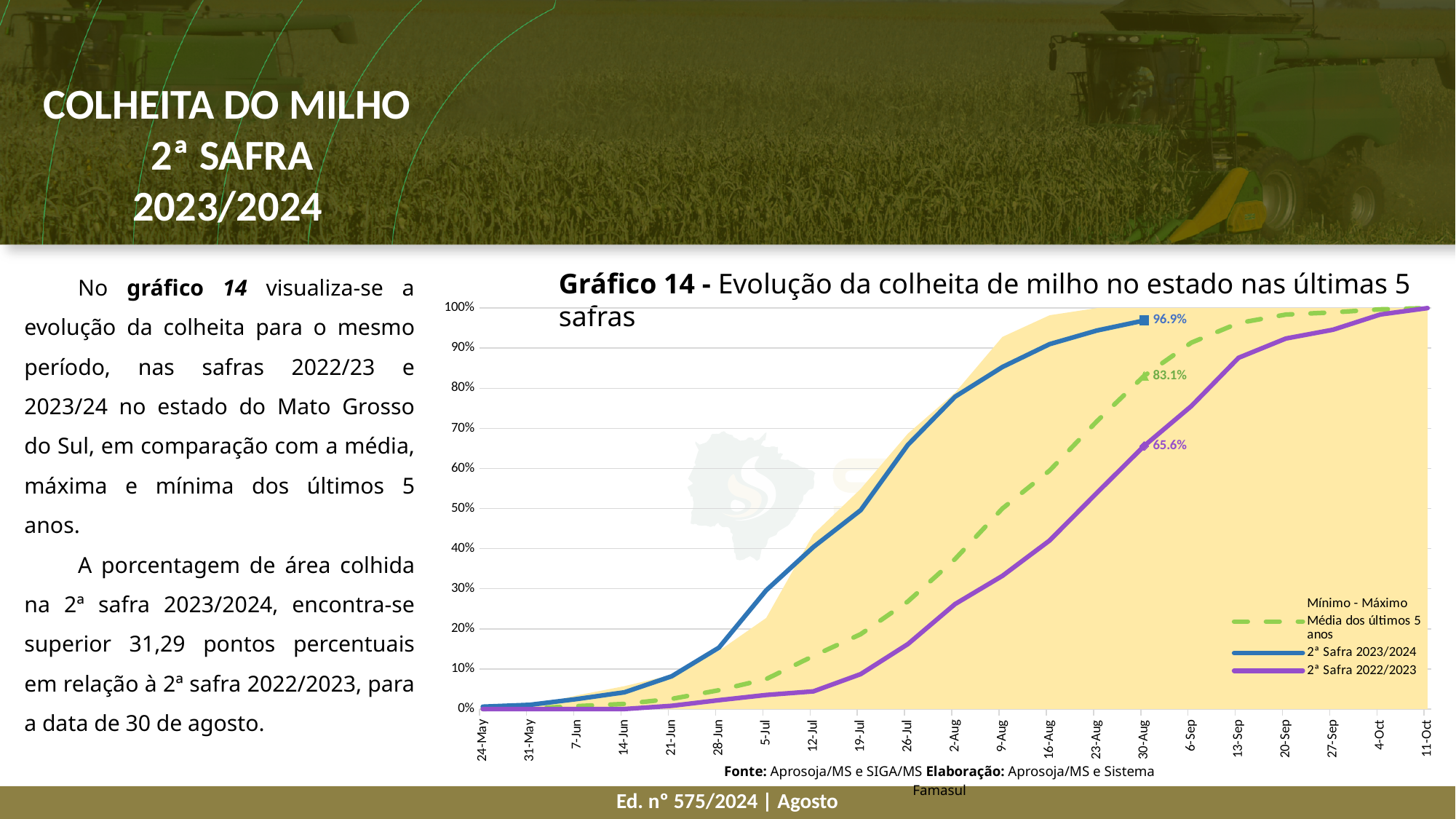
Do the values of the 2ª Safra 2023/2024 series rise or fall from 24-May to 30-Aug? rise How many dates are shown on the x axis of the chart? 21 What is the value of the 2ª Safra 2022/2023 series at 30-Aug? 65.6% At 30-Aug, which series has the higher value: 2ª Safra 2023/2024 or 2ª Safra 2022/2023? 2ª Safra 2023/2024 How many entries does the chart legend list? 4 At 30-Aug, what is the difference between the 2ª Safra 2023/2024 value and the 2ª Safra 2022/2023 value? 31.3 percentage points What kind of chart is Gráfico 14? a combination area and line chart (lines over a shaded min–max area) What is the value of the Média dos últimos 5 anos series at 30-Aug? 83.1% At 30-Aug, what is the difference between the 2ª Safra 2023/2024 value and the Média dos últimos 5 anos value? 13.8 percentage points What is the value of the 2ª Safra 2023/2024 series at 30-Aug? 96.9% Is the value of the 2ª Safra 2022/2023 series at 13-Sep greater or less than 80%? greater Is the value of the 2ª Safra 2023/2024 series at 26-Jul greater or less than 60%? greater